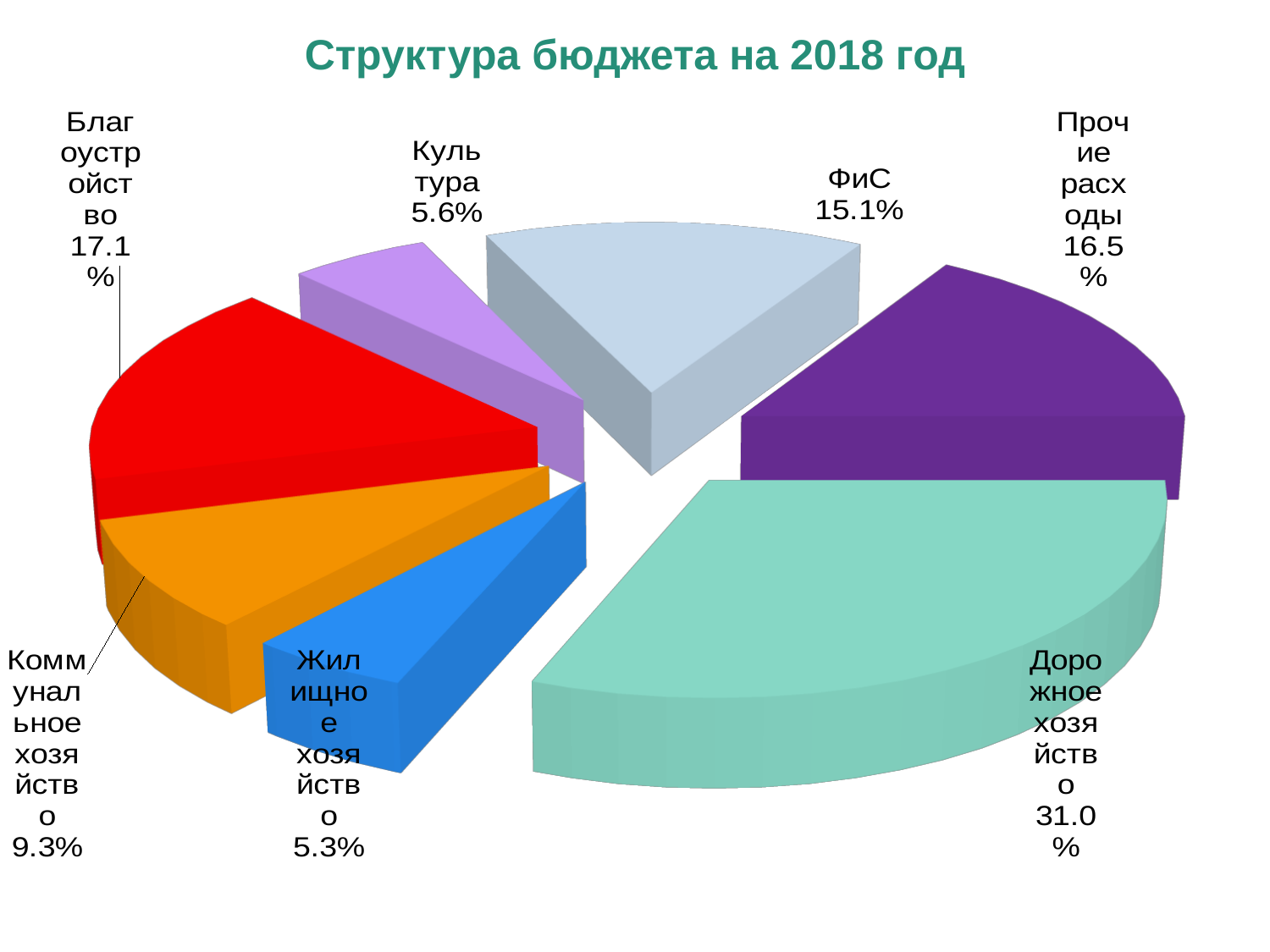
What share of the budget goes to Благоустройство? 17.1% What share of the budget goes to Культура? 5.6% What kind of chart is shown on the slide? Pie chart Which category has the smallest share of the budget? Жилищное хозяйство Which is larger, the share for ФиС or the share for Прочие расходы? Прочие расходы What is the chart's title? Структура бюджета на 2018 год What colour is the slice for Жилищное хозяйство? Blue What share of the budget goes to Коммунальное хозяйство? 9.3% What is the difference between the shares of Дорожное хозяйство and Прочие расходы? 14.5% Which category has the largest share of the budget? Дорожное хозяйство What share of the budget goes to Дорожное хозяйство? 31.0% How many slices does the pie chart have? 7